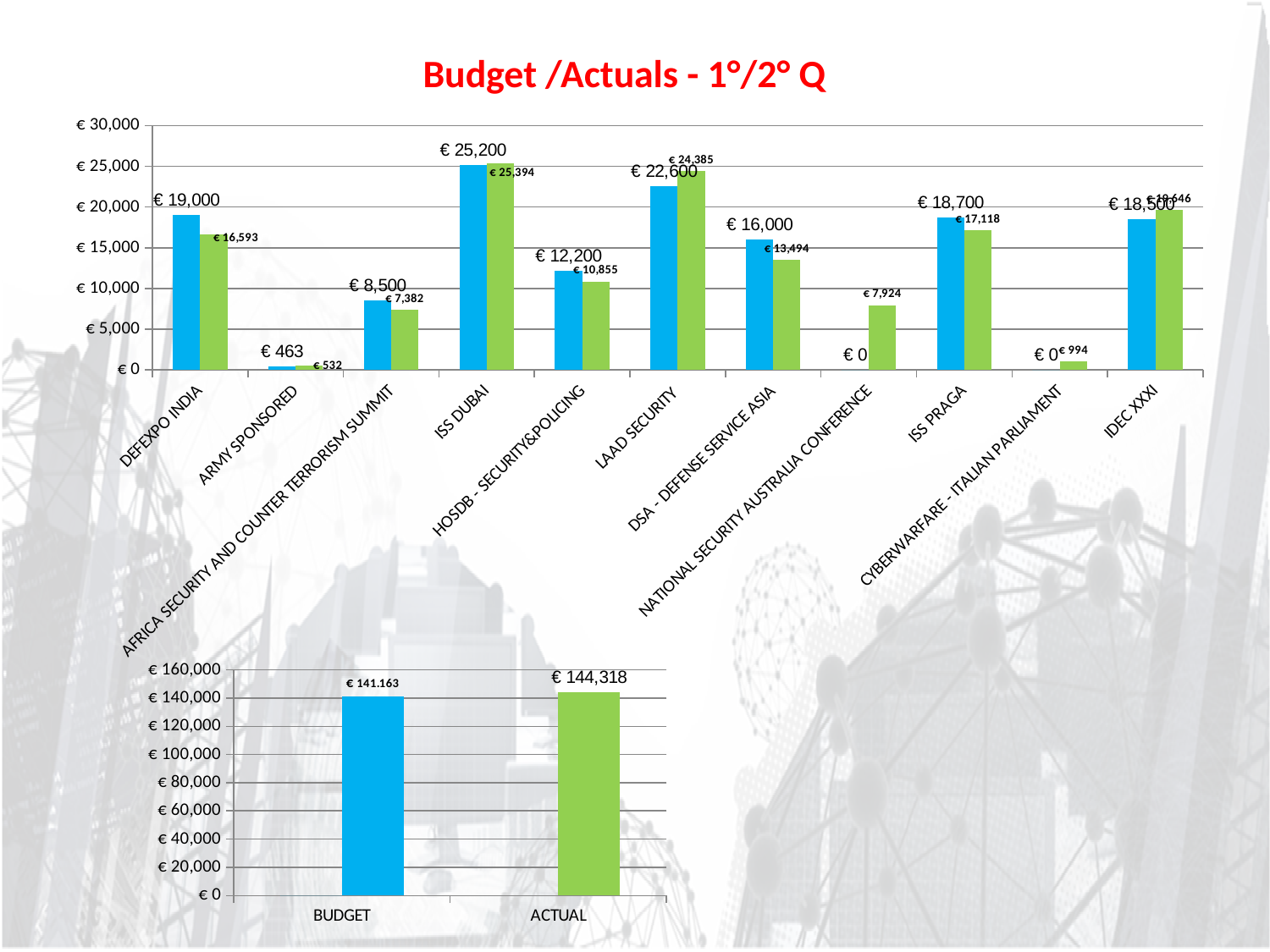
What kind of chart is the bottom chart? bar chart In the top chart, is the actual value (green bar) for HOSDB - SECURITY&POLICING greater or less than € 15,000? less In the top chart, which category has the lowest actual value (green bar)? ARMY SPONSORED In the top chart, what is the actual value (green bar) for NATIONAL SECURITY AUSTRALIA CONFERENCE? € 7,924 In the bottom chart, what is the value for ACTUAL? € 144,318 How many categories are shown on the x axis of the top chart? 11 In the top chart, what is the actual value (green bar) for LAAD SECURITY? € 24,385 In the bottom chart, which is larger: BUDGET or ACTUAL? ACTUAL In the top chart, what is the budget value (blue bar) for ISS DUBAI? € 25,200 In the top chart, which is larger for DSA - DEFENSE SERVICE ASIA: the budget (blue bar) or the actual (green bar)? budget In the top chart, what is the difference between the budget and actual values for DEFEXPO INDIA? € 2,407 In the top chart, which category has the highest budget (blue bar)? ISS DUBAI